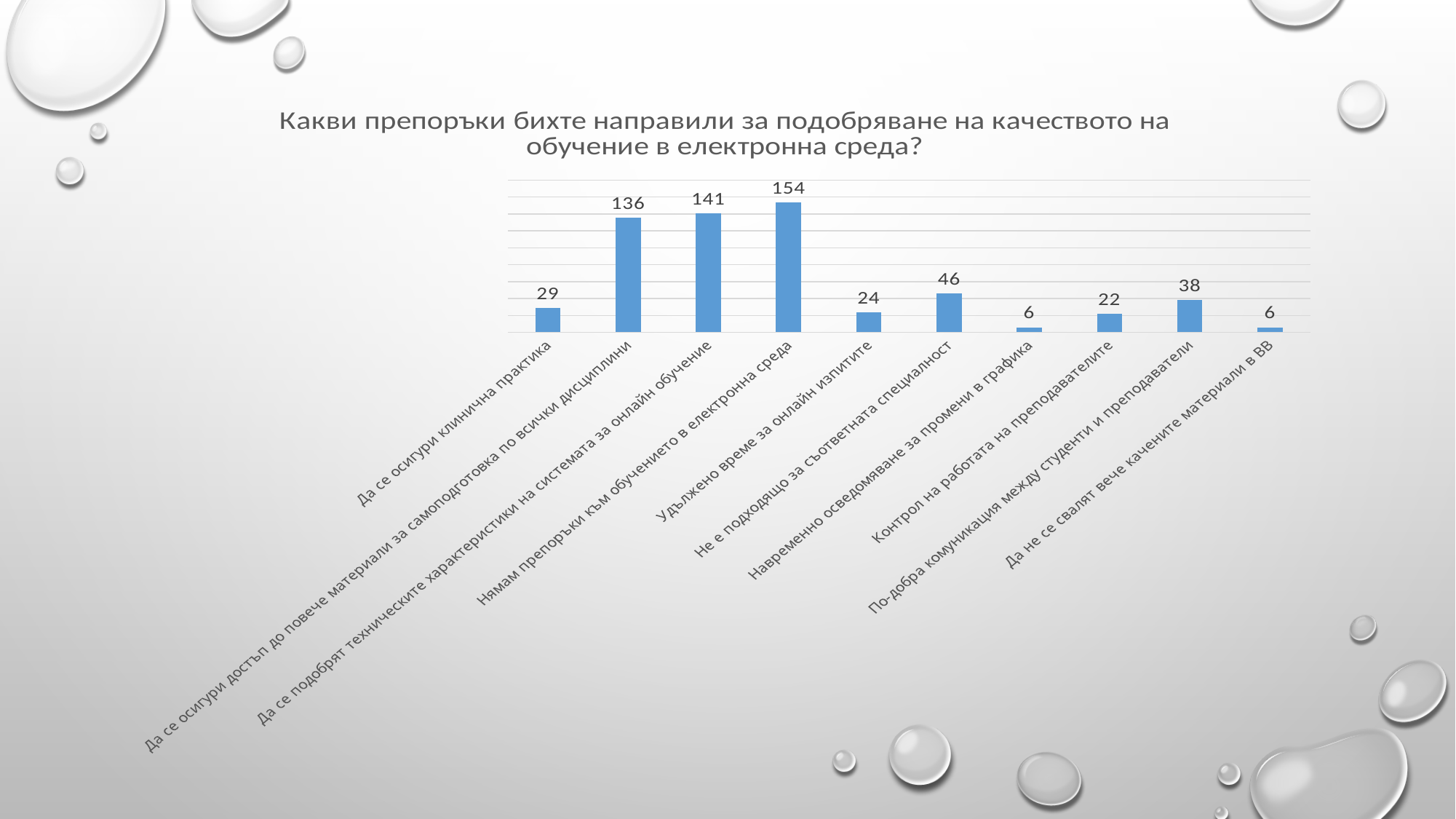
What is the lowest value shown in the chart? 6 Which is larger: the value for "Не е подходящо за съответната специалност" or the value for "Контрол на работата на преподавателите"? Не е подходящо за съответната специалност What value is shown for "Да се осигури клинична практика"? 29 Which category has the highest value? Нямам препоръки към обучението в електронна среда What value is shown for "Нямам препоръки към обучението в електронна среда"? 154 What is the title of the chart? Какви препоръки бихте направили за подобряване на качеството на обучение в електронна среда? How many categories are shown in the chart? 10 What value is shown for "Удължено време за онлайн изпитите"? 24 What is the difference between the values for "Да се подобрят техническите характеристики на системата за онлайн обучение" and "Да се осигури достъп до повече материали за самоподготовка по всички дисциплини"? 5 What kind of chart is shown on the slide? Bar chart What is the difference between the highest value and the value for "Навременно осведомяване за промени в графика"? 148 What value is shown for "По-добра комуникация между студенти и преподаватели"? 38